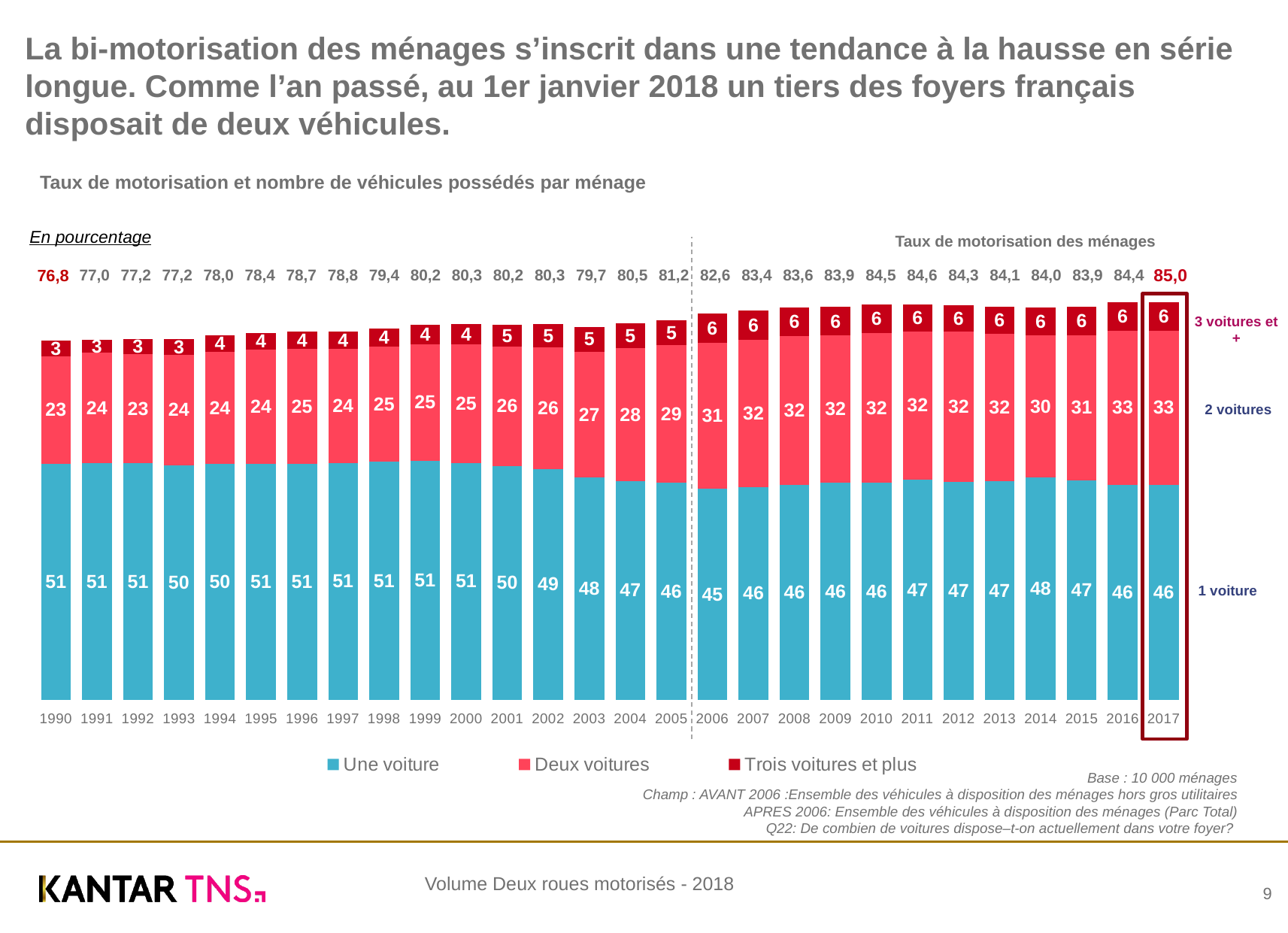
What is the "Taux de motorisation des ménages" shown for 2017? 85,0 Which year has the highest "Taux de motorisation des ménages"? 2017 By how much did the "Deux voitures" value increase from 1990 to 2017? 10 How many years are shown on the x axis of the chart? 28 What is the value for "Une voiture" in 1990? 51 How many series does the legend list? 3 Which year has the lowest "Taux de motorisation des ménages"? 1990 What is the value for "Trois voitures et plus" in 2005? 5 What is the value for "Deux voitures" in 2017? 33 What is the total of the stacked bar for 2017? 85 Which year has the larger "Une voiture" value, 1990 or 2006? 1990 What kind of chart is shown on the slide? Stacked bar chart